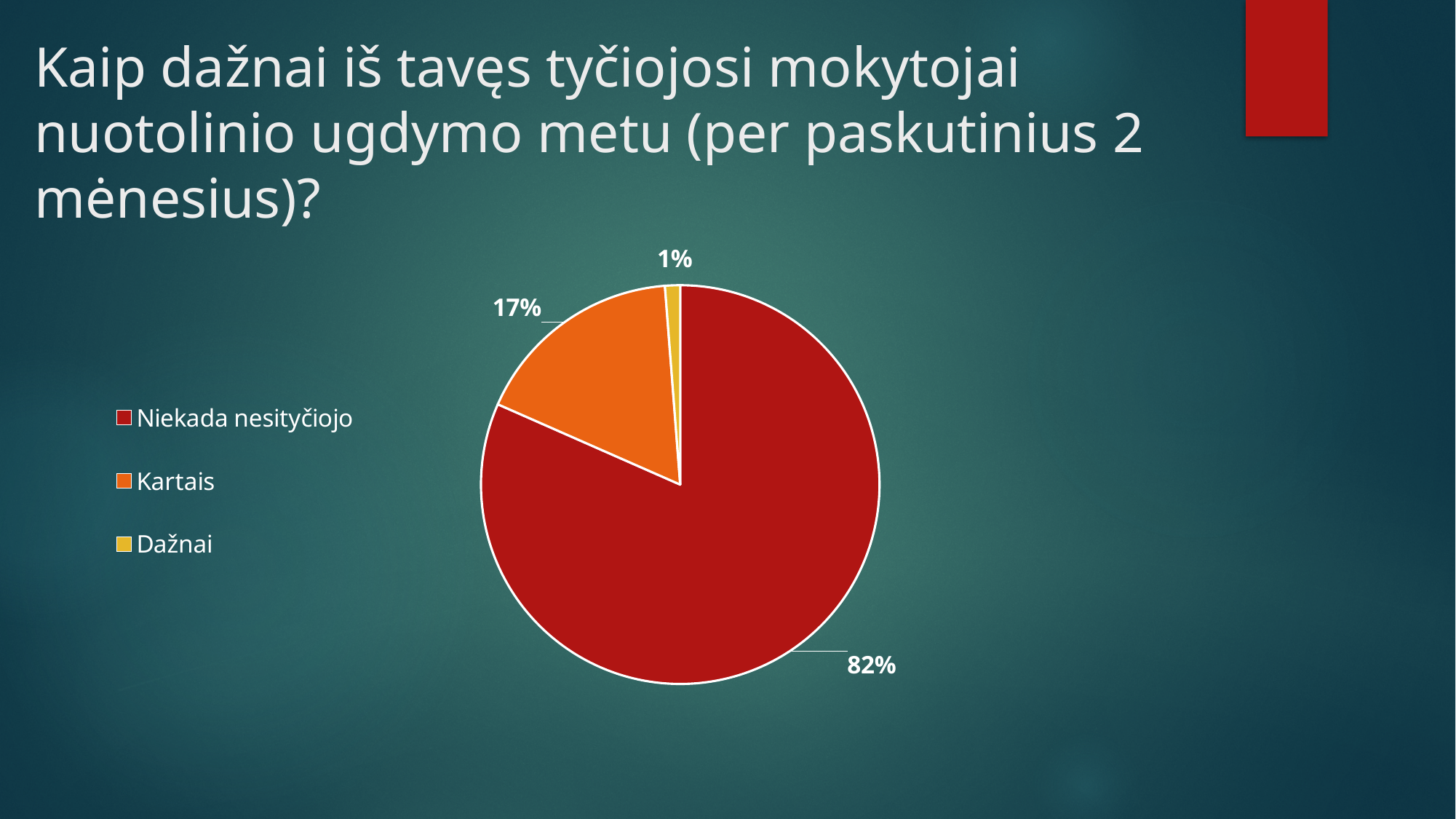
What colour is the slice for "Kartais"? Orange Which slice is larger, "Kartais" or "Dažnai"? Kartais Which category has the smallest slice of the pie? Dažnai What kind of chart is shown on the slide? Pie chart What percentage of the pie is labelled for "Dažnai"? 1% Which legend entry is listed first? Niekada nesityčiojo What percentage of the pie is labelled for "Niekada nesityčiojo"? 82% What is the difference in percentage points between the "Kartais" slice and the "Dažnai" slice? 16 What percentage of the pie is labelled for "Kartais"? 17% What is the difference in percentage points between the "Niekada nesityčiojo" slice and the "Kartais" slice? 65 How many categories does the pie chart show? 3 Which category has the largest slice of the pie? Niekada nesityčiojo